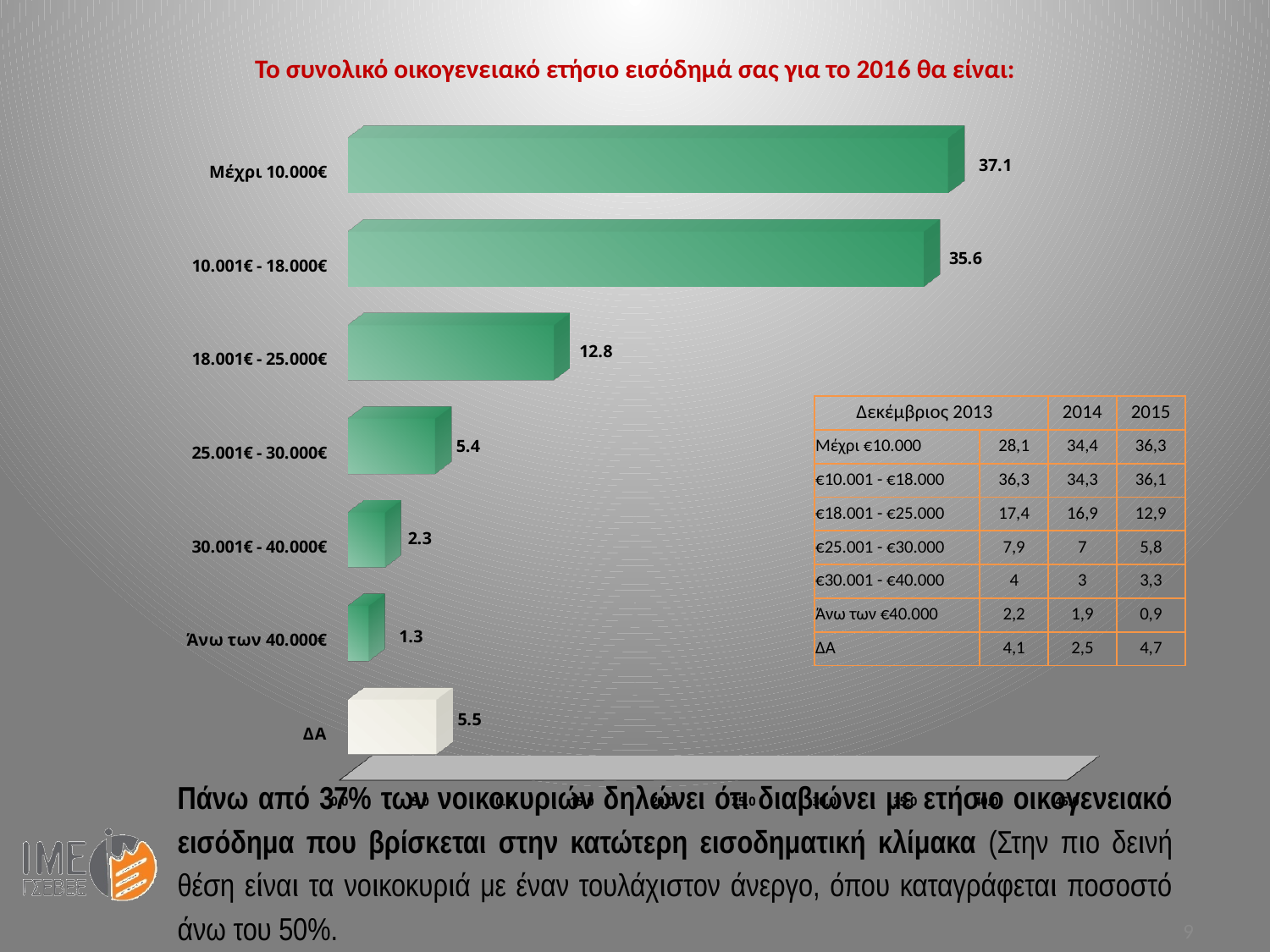
What value is shown for the category '18.001€ - 25.000€'? 12.8 What value is shown for the category 'Μέχρι 10.000€'? 37.1 What value is shown for the category '10.001€ - 18.000€'? 35.6 Which category has the lowest value in the bar chart? Άνω των 40.000€ Which category has the highest value in the bar chart? Μέχρι 10.000€ What value is shown for the category 'ΔΑ'? 5.5 Which is larger: the value for '25.001€ - 30.000€' or the value for 'ΔΑ'? ΔΑ What is the difference between the values for 'Μέχρι 10.000€' and '10.001€ - 18.000€'? 1.5 What is the title of the chart? Το συνολικό οικογενειακό ετήσιο εισόδημά σας για το 2016 θα είναι: What is the difference between the values for '18.001€ - 25.000€' and '25.001€ - 30.000€'? 7.4 How many categories are shown in the bar chart? 7 What type of chart is shown on the slide? Bar chart